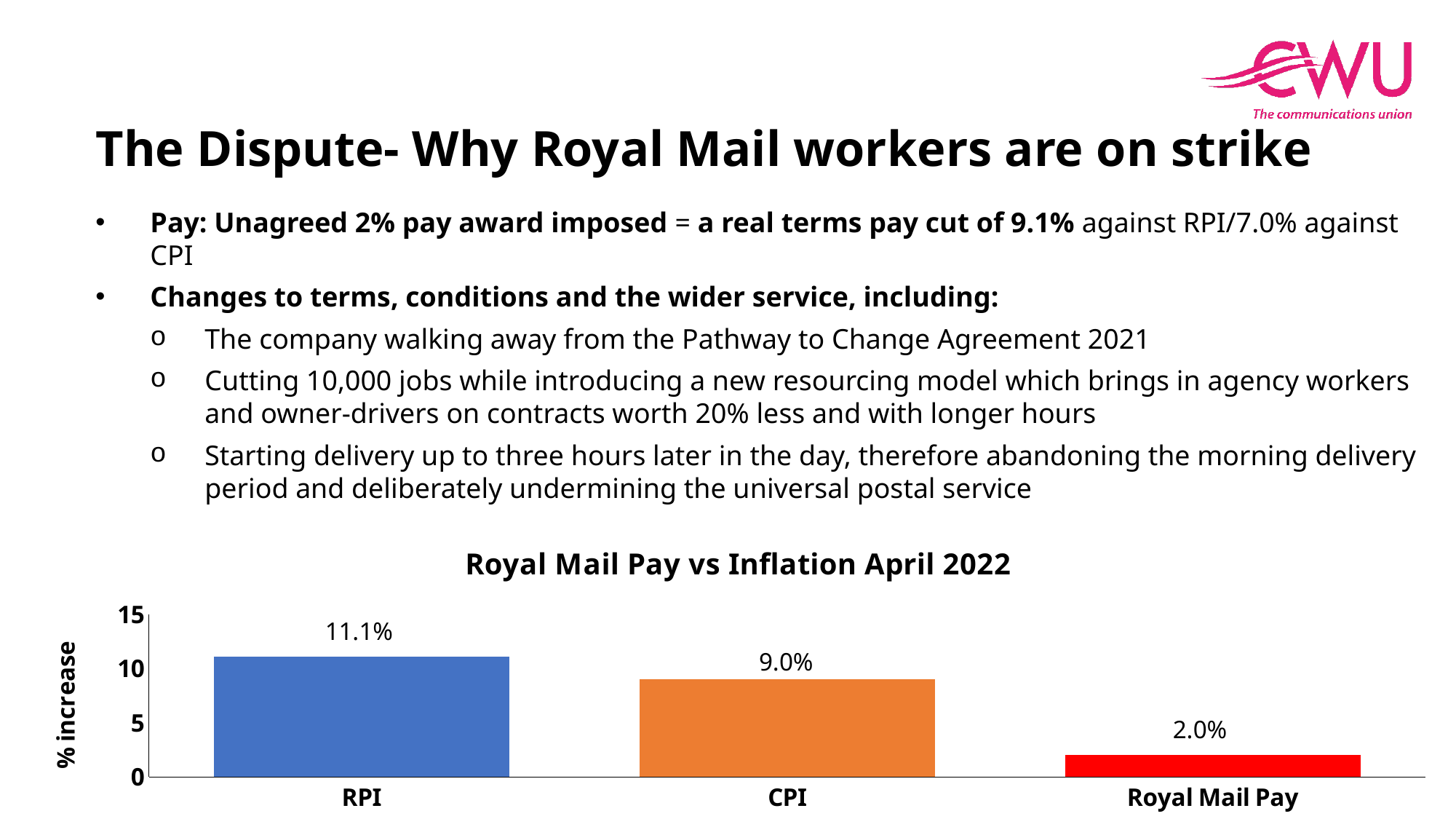
Is the value for CPI greater or less than 5? greater How many categories are shown in the chart? 3 What is the value for CPI in the chart? 9.0% Which category has the highest value in the chart? RPI What is the value for RPI in the chart? 11.1% What is the difference between the CPI value and the Royal Mail Pay value? 7.0% Which is larger, the value for RPI or the value for CPI? RPI What is the value for Royal Mail Pay in the chart? 2.0% Which category has the lowest value in the chart? Royal Mail Pay What is the title of the chart? Royal Mail Pay vs Inflation April 2022 What is the difference between the RPI value and the Royal Mail Pay value? 9.1% What kind of chart is shown on the slide? bar chart